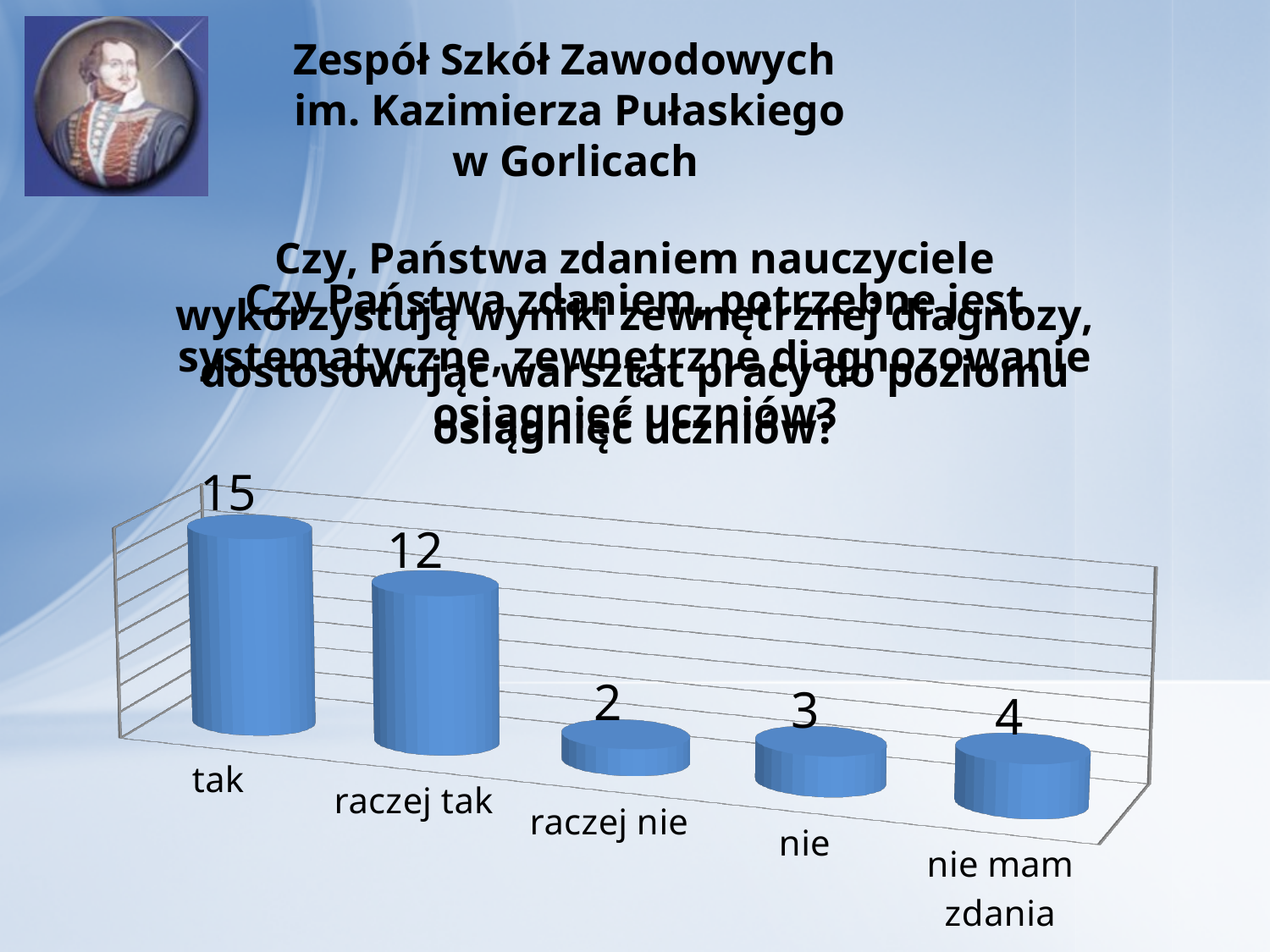
Which category has the highest value? tak Which category has the lowest value? raczej nie What is the difference between the values for "tak" and "raczej tak"? 3 What is the value for "raczej nie"? 2 What is the difference between the values for "nie mam zdania" and "raczej nie"? 2 How many categories are shown in the chart? 5 What kind of chart is shown on the slide? bar chart What is the value for "tak"? 15 What is the value for "raczej tak"? 12 Which is larger, the value for "nie" or the value for "nie mam zdania"? nie mam zdania What is the value for "nie mam zdania"? 4 What is the value for "nie"? 3